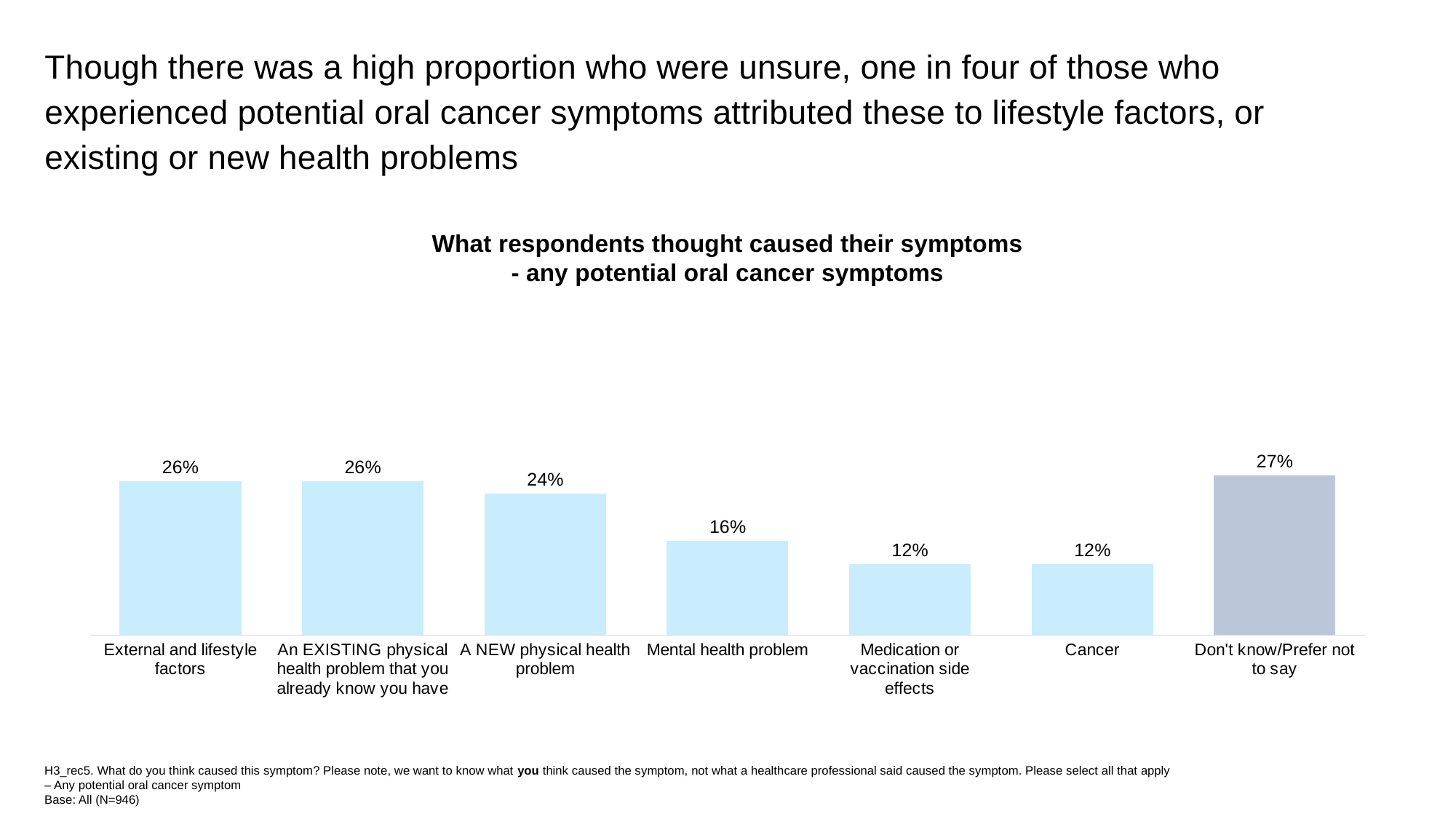
What is the value for 'A NEW physical health problem'? 24% What is the value for 'Mental health problem'? 16% Which category has the highest value? Don't know/Prefer not to say How many categories are shown in the chart? 7 What kind of chart is shown on the slide? Bar chart Which bar is shaded a different colour (grey) from the others? Don't know/Prefer not to say Which is larger: 'A NEW physical health problem' or 'Medication or vaccination side effects'? A NEW physical health problem What is the difference between 'Don't know/Prefer not to say' and 'Mental health problem'? 11 percentage points What is the title of the chart? What respondents thought caused their symptoms - any potential oral cancer symptoms What is the difference between 'External and lifestyle factors' and 'Cancer'? 14 percentage points What is the value for 'Cancer'? 12% What percentage of respondents attributed their symptoms to external and lifestyle factors? 26%